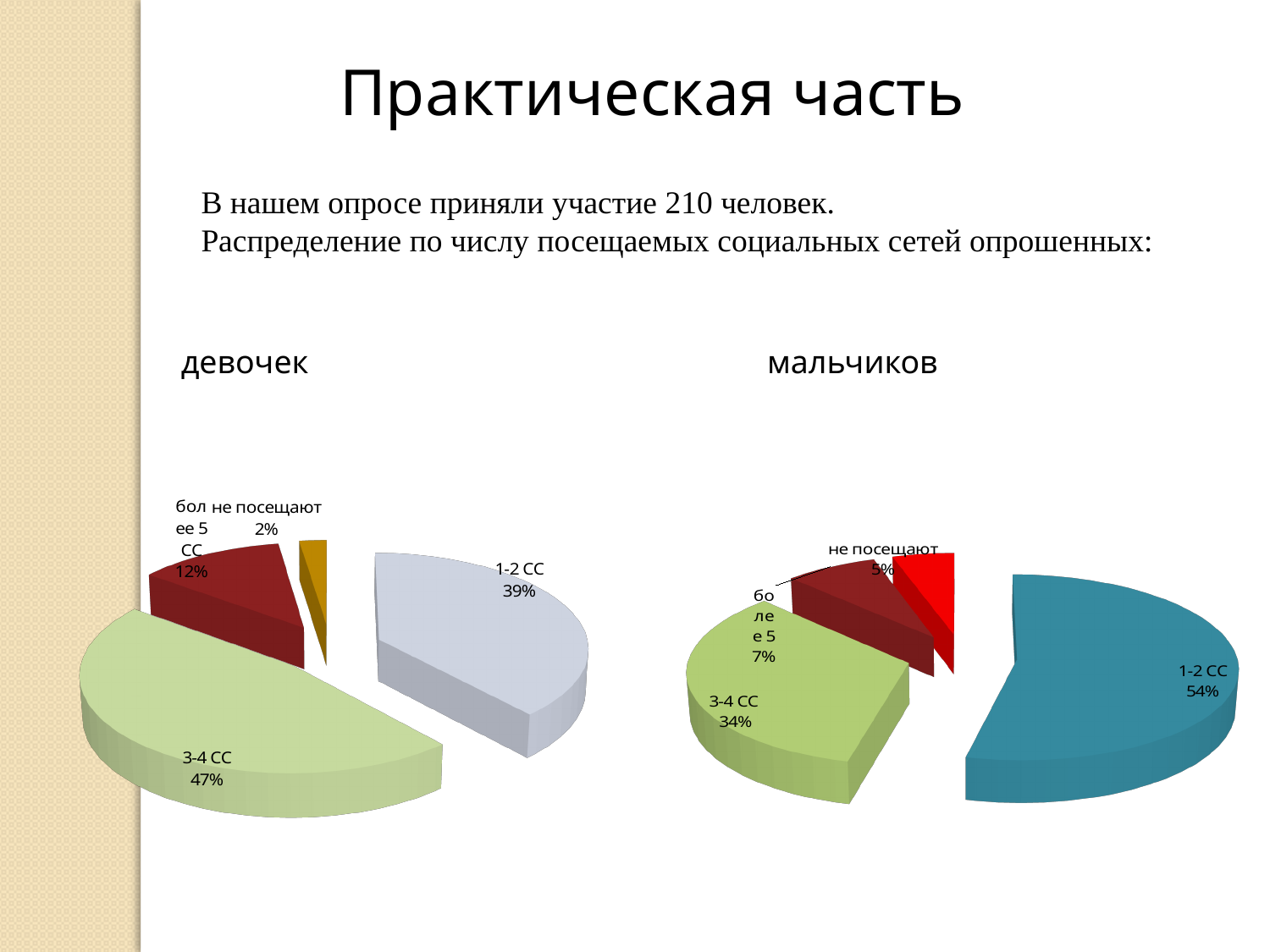
What type of chart is used for 'девочек'? Pie chart In the 'мальчиков' pie chart, what share is labelled for '1-2 СС'? 54% In the 'девочек' pie chart, what share is labelled for 'не посещают'? 2% In the 'мальчиков' pie chart, what share is labelled for 'более 5'? 7% In the 'мальчиков' pie chart, what share is labelled for '3-4 СС'? 34% How many slices does the 'мальчиков' pie chart have? 4 In the 'девочек' pie chart, which category has the largest share? 3-4 СС In the 'девочек' pie chart, what share is labelled for '3-4 СС'? 47% Which chart shows a larger share for '1-2 СС', 'девочек' or 'мальчиков'? мальчиков In the 'мальчиков' pie chart, which category has the smallest share? не посещают In the 'девочек' pie chart, what share is labelled for '1-2 СС'? 39% In the 'девочек' pie chart, what is the difference between the shares for '3-4 СС' and '1-2 СС'? 8%